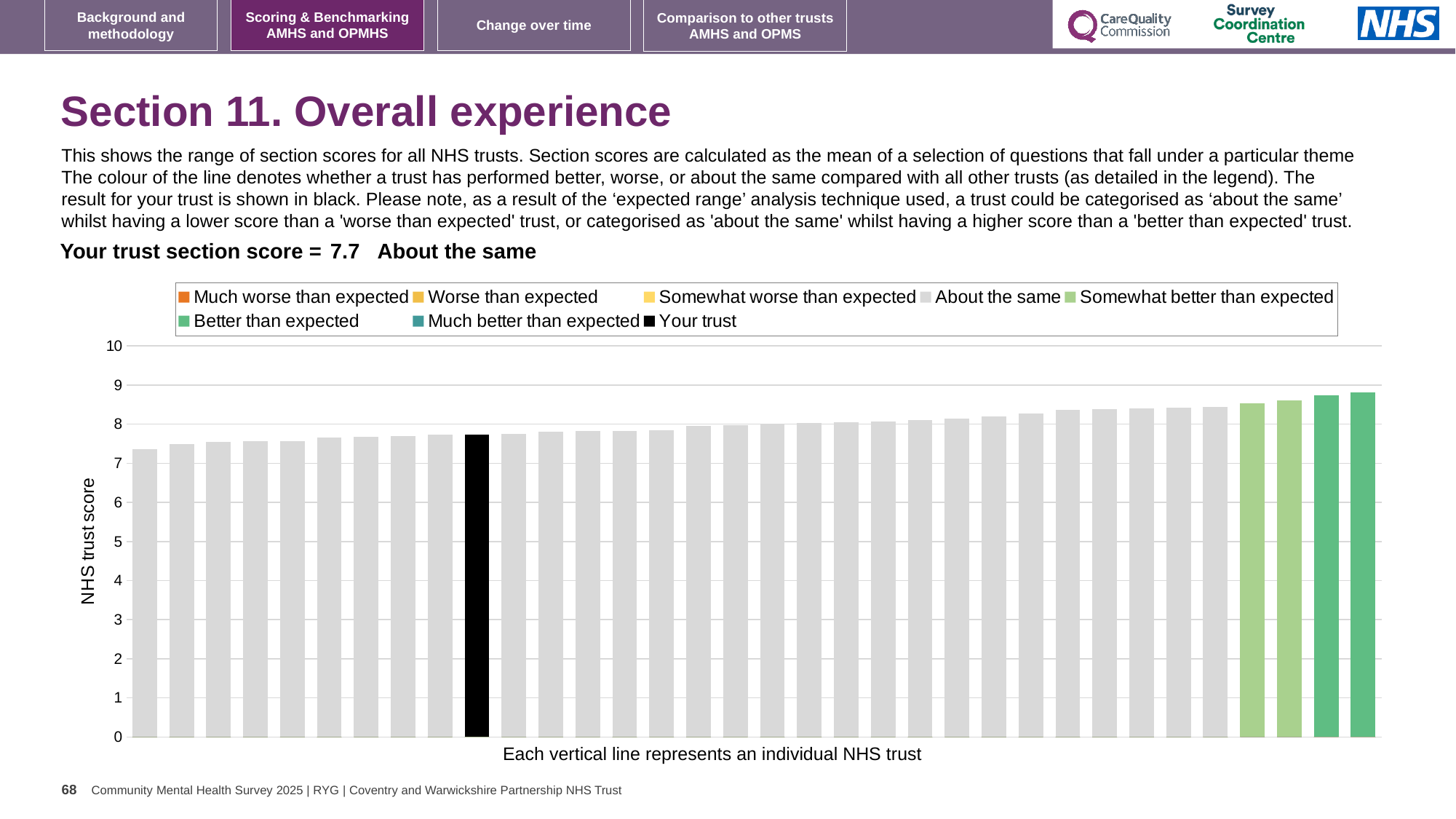
What is the label on the vertical axis of the chart? NHS trust score How many bars are shown in the 'Somewhat better than expected' colour? 2 Is the value of the shortest bar greater or less than 7? greater Is the value of the black 'Your trust' bar greater or less than 8? less Do the bar values rise or fall from left to right along the x axis? rise Is the value of the tallest bar greater or less than 8? greater How many entries does the chart legend list? 8 What is the section score for your trust? 7.7 Which benchmarking category is your trust placed in for this section? About the same How many bars are shown in the 'Better than expected' colour? 2 What kind of chart is shown on the slide? bar chart